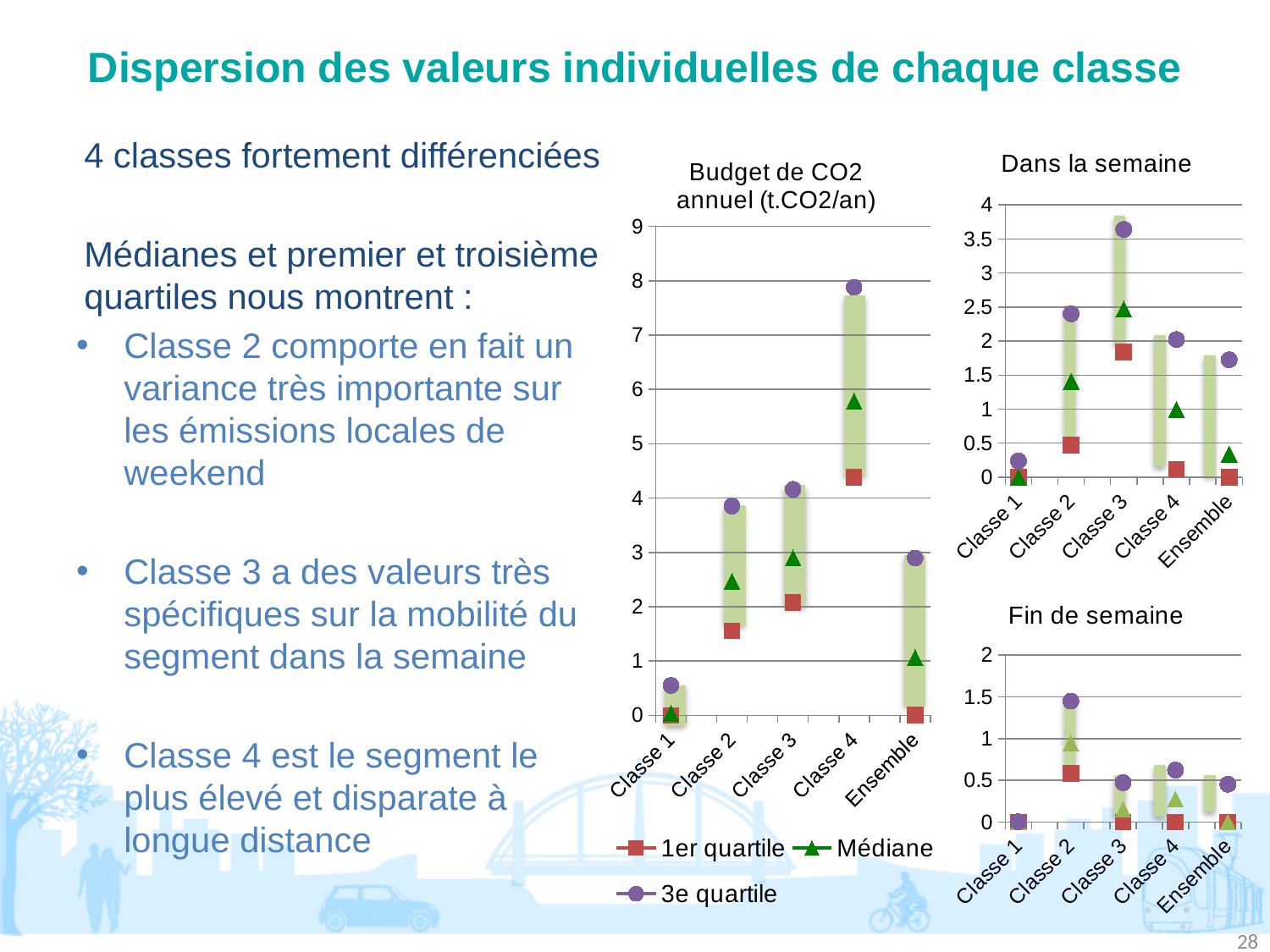
In the 'Dans la semaine' chart, is the 1er quartile value for Classe 2 greater or less than 1? less In the 'Dans la semaine' chart, is the 3e quartile value for Classe 3 greater or less than 3.5? greater In the 'Fin de semaine' chart, is the Médiane value for Classe 2 greater or less than 0.5? greater How many series does the legend below the 'Budget de CO2 annuel (t.CO2/an)' chart list? 3 In the 'Budget de CO2 annuel (t.CO2/an)' chart, which is larger, the 1er quartile for Classe 3 or for Classe 2? Classe 3 In the 'Fin de semaine' chart, which category has the highest 3e quartile value? Classe 2 In the 'Dans la semaine' chart, which category has the highest Médiane value? Classe 3 In the 'Budget de CO2 annuel (t.CO2/an)' chart, which category has the highest 3e quartile value? Classe 4 What are the three series named in the legend below the 'Budget de CO2 annuel (t.CO2/an)' chart? 1er quartile, Médiane, 3e quartile In the 'Budget de CO2 annuel (t.CO2/an)' chart, how many categories are shown on the x axis? 5